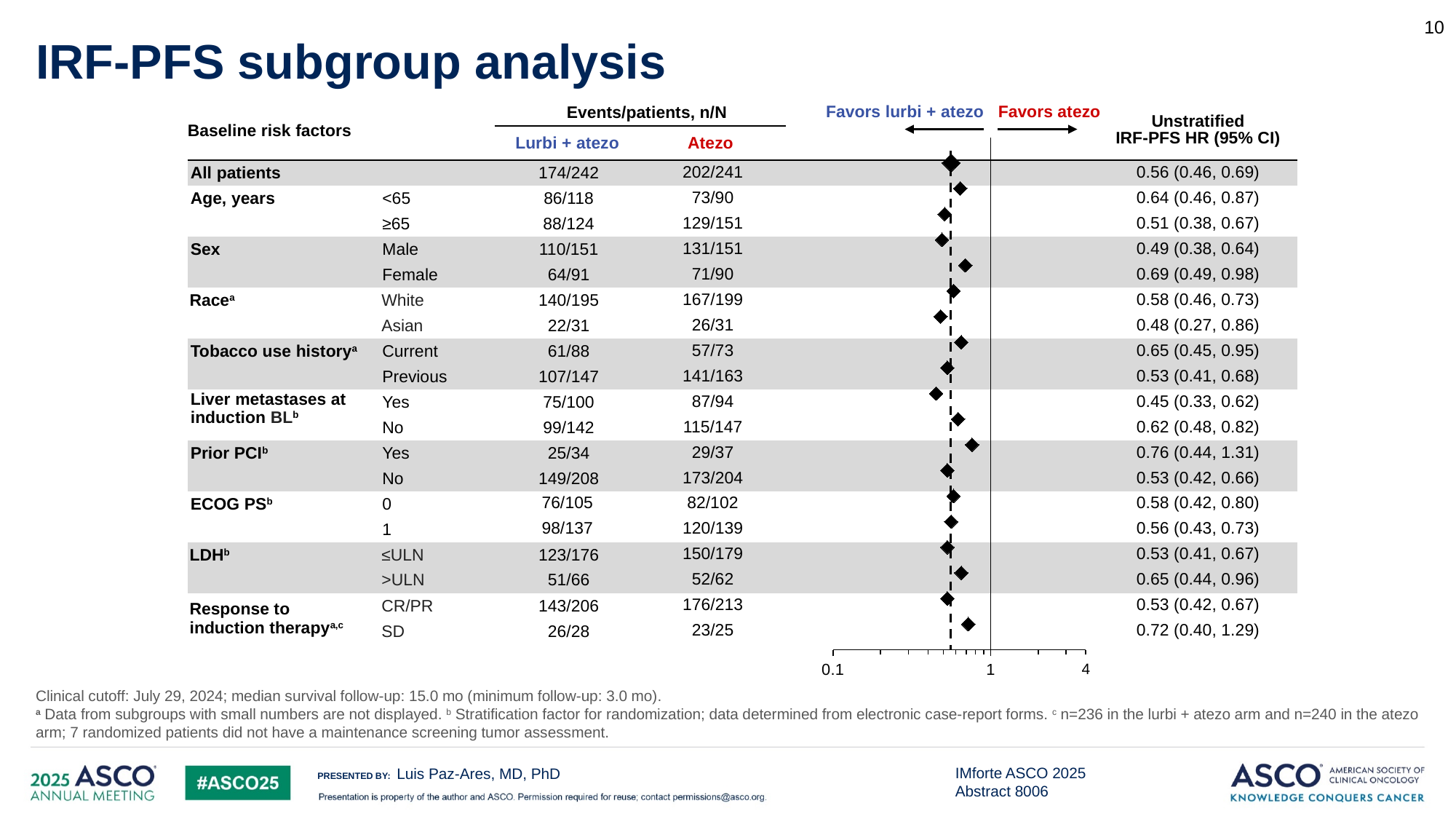
What is the difference between the hazard ratio point estimates for Female and Male patients? 0.20 What is the IRF-PFS HR (95% CI) for patients with liver metastases at induction baseline (Yes)? 0.45 (0.33, 0.62) Is the hazard ratio point estimate for the SD response subgroup greater or less than 1? less Which subgroup has the lowest IRF-PFS hazard ratio point estimate? Liver metastases at induction BL, Yes Which has the larger hazard ratio point estimate: Age <65 or Age ≥65? Age <65 What is the unstratified IRF-PFS hazard ratio for all patients? 0.56 (0.46, 0.69) How many subgroup hazard ratio points are plotted in the forest plot? 19 What are the tick labels shown on the x axis of the forest plot? 0.1, 1, 4 Which subgroup has the highest IRF-PFS hazard ratio point estimate? Prior PCI, Yes What does the left side of the forest plot (hazard ratio below 1) favor? Lurbi + atezo What is the IRF-PFS HR (95% CI) for the Female subgroup? 0.69 (0.49, 0.98) What kind of chart is shown on the slide? Forest plot